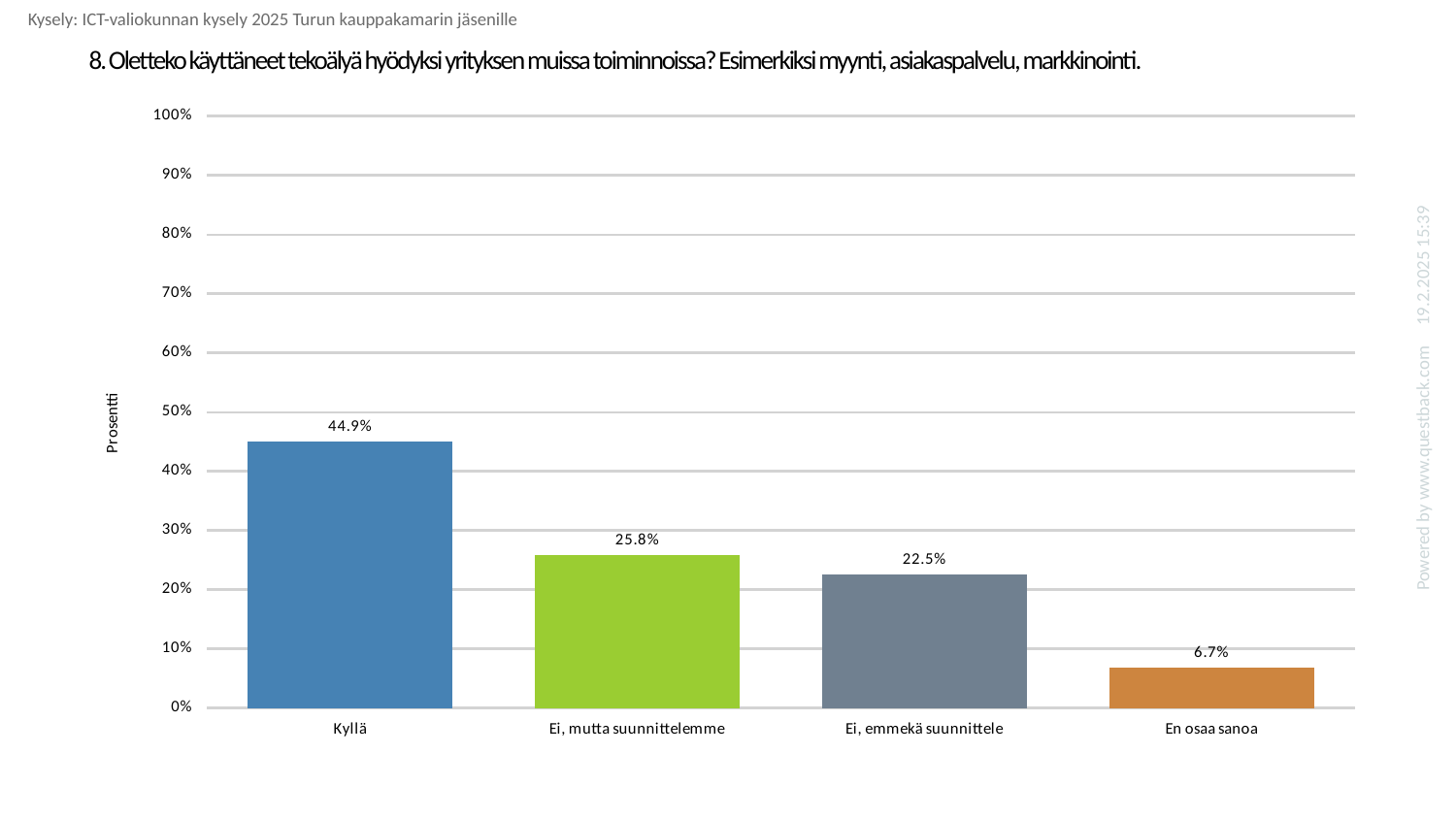
What is the value for "Ei, mutta suunnittelemme"? 25.8% How many categories are shown on the x axis? 4 What is the value for "En osaa sanoa"? 6.7% What is the difference between the values for "Kyllä" and "Ei, mutta suunnittelemme"? 19.1% What kind of chart is shown on the slide? bar chart Is the value for "Kyllä" greater or less than 40%? greater What is the value for "Ei, emmekä suunnittele"? 22.5% Which category has the highest value? Kyllä What is the label of the y axis? Prosentti What is the value for "Kyllä"? 44.9% Which is larger, the value for "Ei, mutta suunnittelemme" or "Ei, emmekä suunnittele"? Ei, mutta suunnittelemme Which category has the lowest value? En osaa sanoa